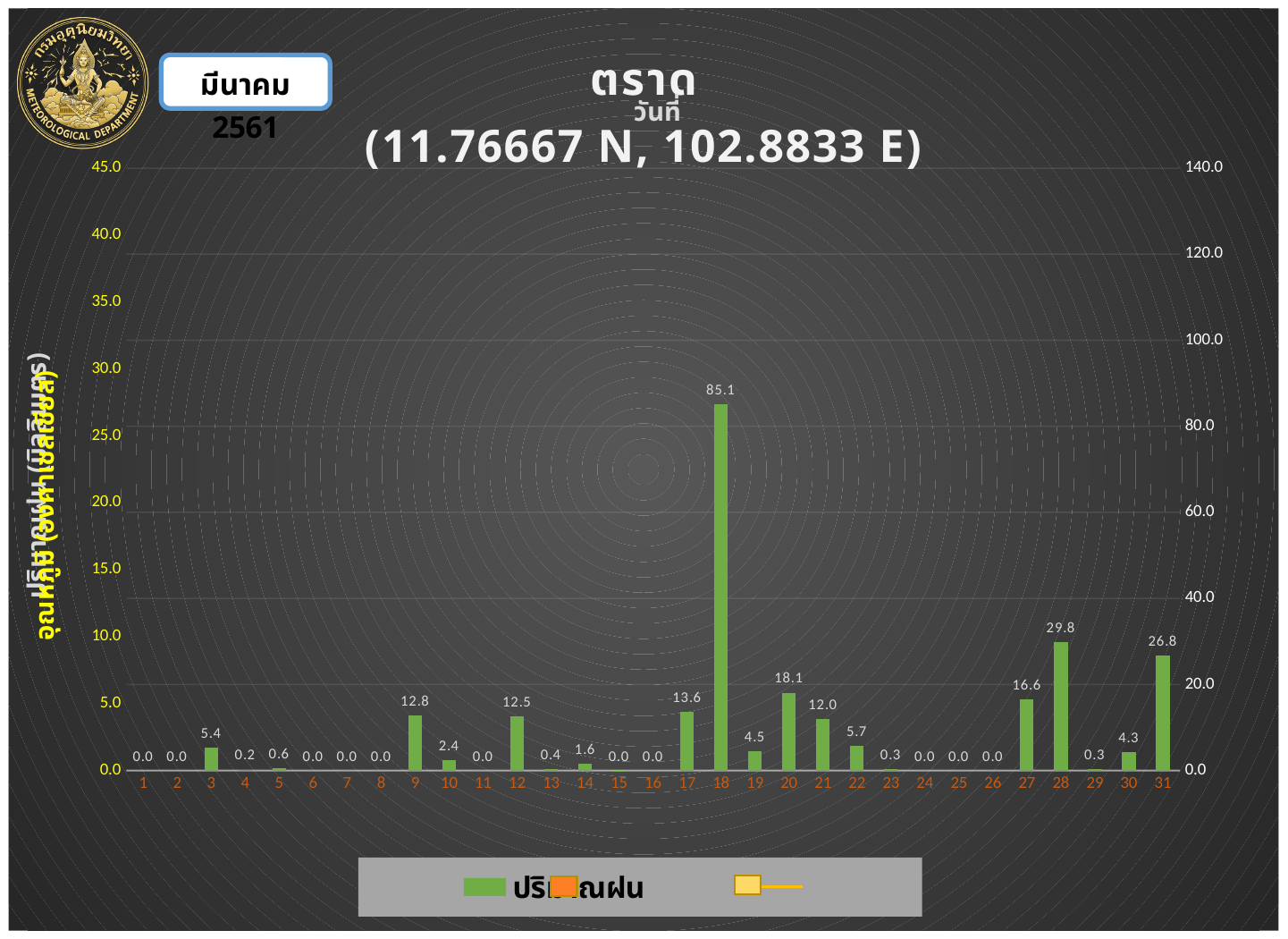
What is the rainfall value for day 9? 12.8 Which is larger, the rainfall value for day 17 or for day 12? day 17 What is the rainfall value for day 18? 85.1 What is the difference between the rainfall values for day 28 and day 31? 3.0 What is the rainfall value for day 28? 29.8 What is the name of the station shown in the chart title? ตราด What is the difference between the rainfall values for day 20 and day 21? 6.1 Which is larger, the rainfall value for day 27 or for day 22? day 27 How many days are shown on the x axis? 31 Which day has the highest rainfall value? 18 What kind of chart is shown on the slide? bar chart What is the rainfall value for day 31? 26.8